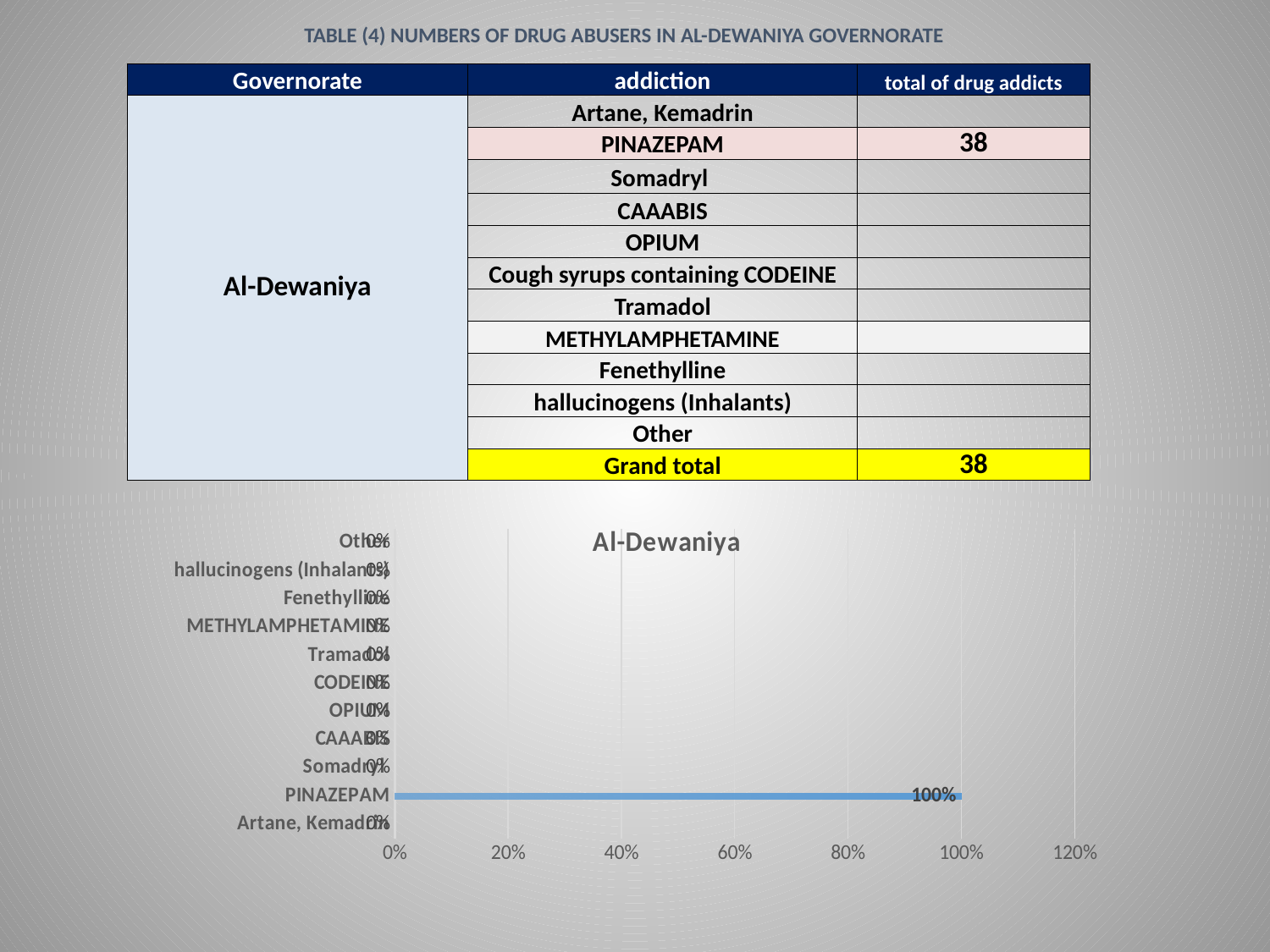
What is the title of the chart? Al-Dewaniya What is the difference between the values for PINAZEPAM and CAAABIS in the chart? 100% Which category has the highest value in the chart? PINAZEPAM Is the value for PINAZEPAM in the chart greater or less than 80%? greater What kind of chart is shown below the table? bar chart What is the maximum value shown on the chart's horizontal axis? 120% What is the value for PINAZEPAM in the chart? 100% What is the value for OPIUM in the chart? 0% How many categories are shown on the chart's vertical axis? 11 What is the value for Tramadol in the chart? 0% Which is larger in the chart, the value for PINAZEPAM or the value for Somadryl? PINAZEPAM What is the value for Fenethylline in the chart? 0%